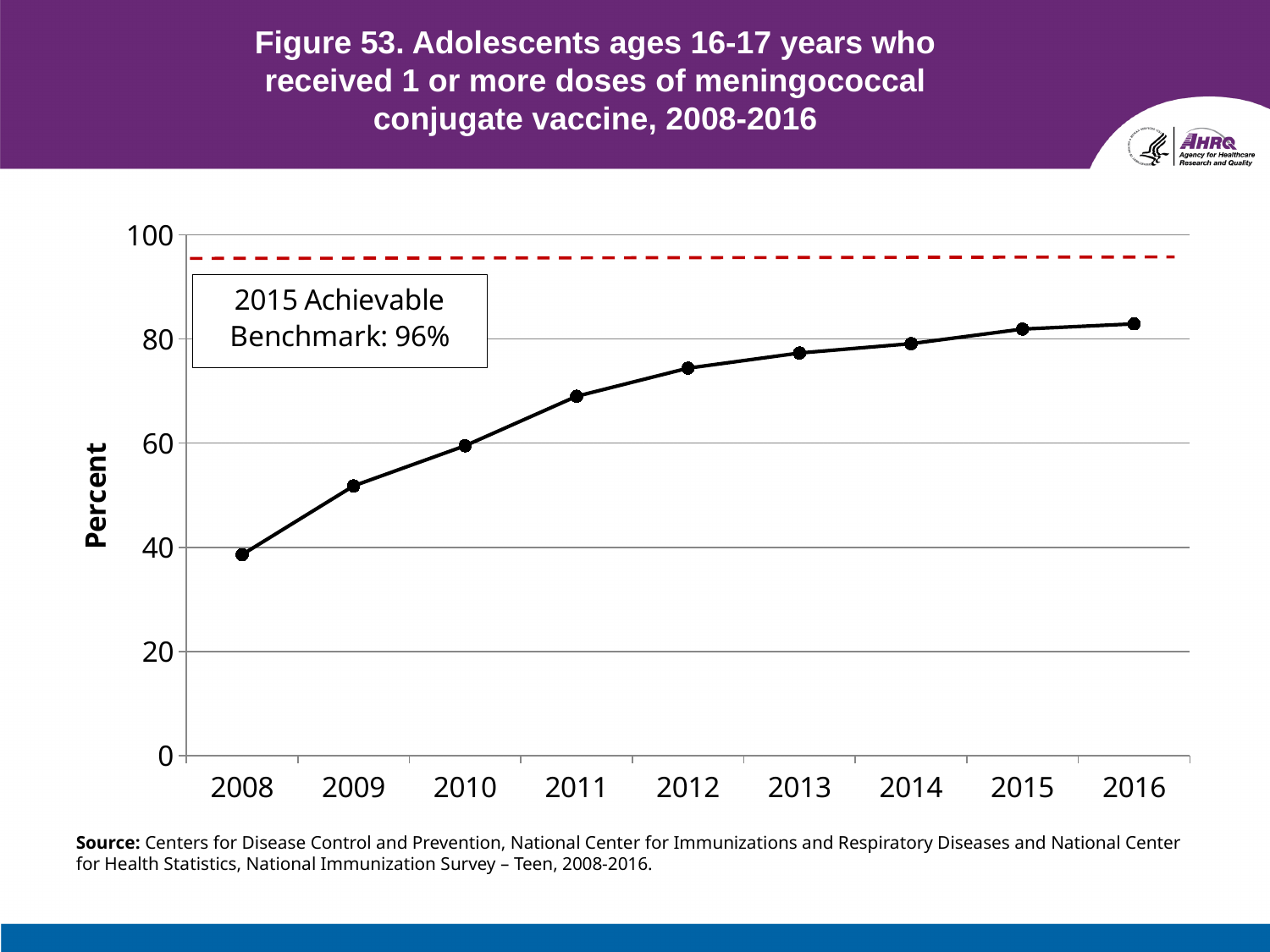
Is the value for 2009 greater or less than 40? greater Is the value for 2016 greater or less than 80? greater What kind of chart is shown on the slide? Line chart What is the label on the y axis of the chart? Percent How many years are plotted on the x axis of the chart? 9 What is the 2015 Achievable Benchmark shown on the chart? 96% Which year has the lowest value on the chart? 2008 Is the value for 2013 greater or less than 80? less Do the plotted values rise or fall from 2008 to 2016? Rise Which year has the larger value, 2009 or 2011? 2011